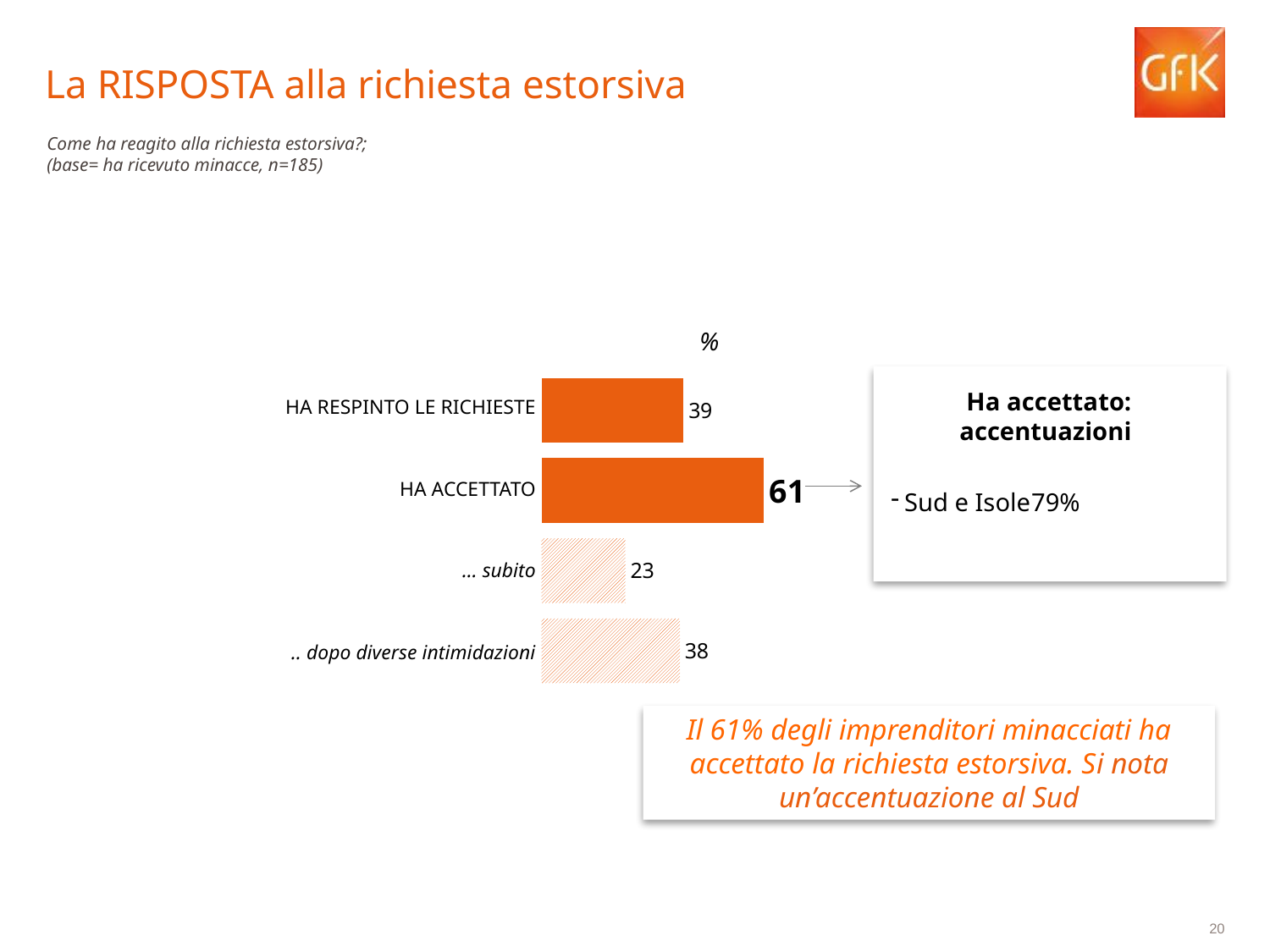
Which is larger, HA ACCETTATO or HA RESPINTO LE RICHIESTE? HA ACCETTATO What is the value for HA RESPINTO LE RICHIESTE? 39 What is the value for the '... subito' bar? 23 What unit symbol is shown above the bars? % What is the value for HA ACCETTATO? 61 Which category has the highest value? HA ACCETTATO What kind of chart is shown on the slide? bar chart How many bars are shown in the chart? 4 What is the difference between '.. dopo diverse intimidazioni' and '... subito'? 15 What is the difference between HA ACCETTATO and HA RESPINTO LE RICHIESTE? 22 What is the value for '.. dopo diverse intimidazioni'? 38 Which category has the lowest value? ... subito